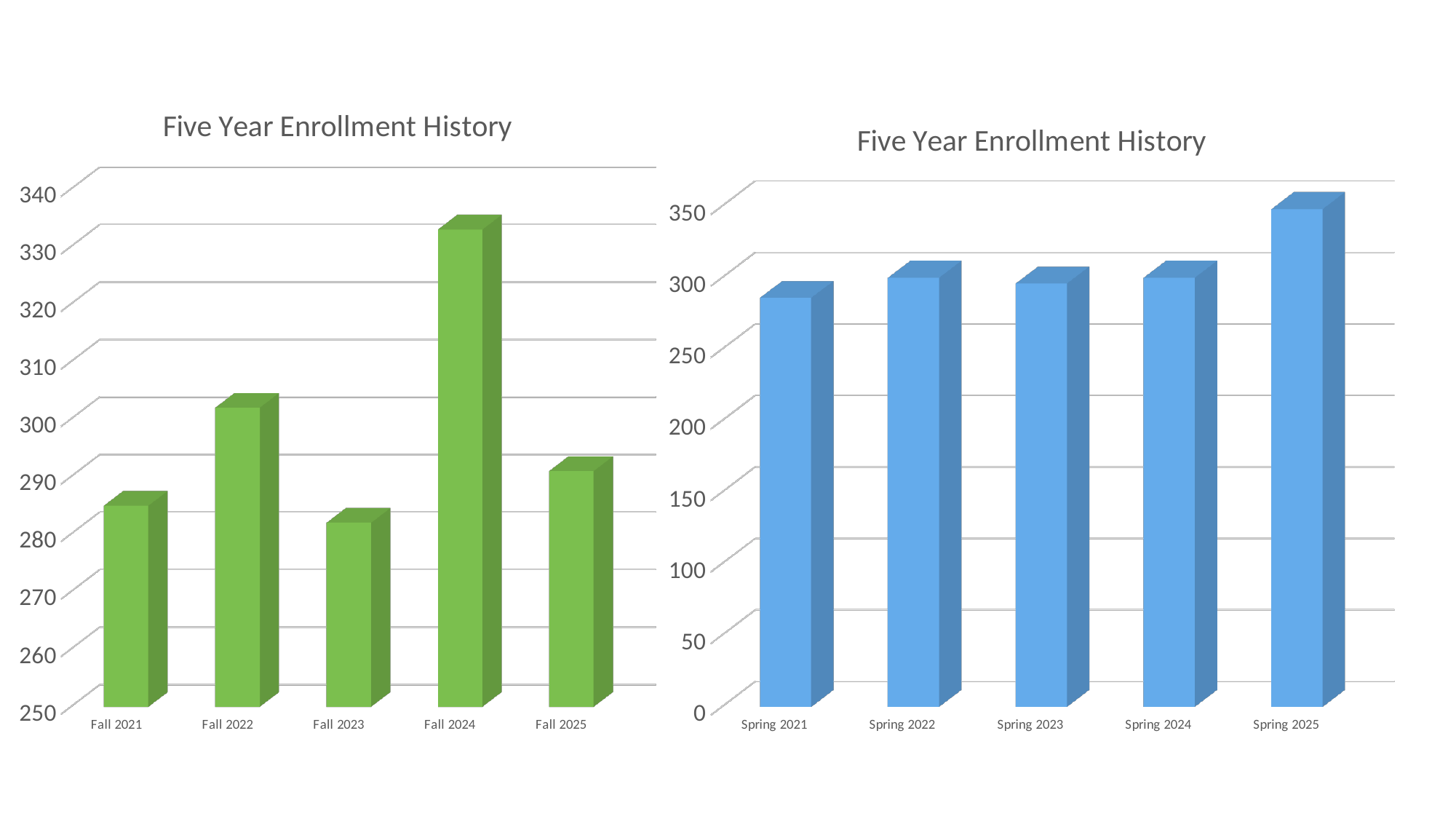
On the left chart, is the value for Fall 2024 greater or less than 320? greater What kind of chart is the left chart? bar chart On the right chart, is the value for Spring 2025 greater or less than 300? greater On the left chart (green bars), which term has the lowest enrollment? Fall 2023 What is the title of the right chart? Five Year Enrollment History On the left chart, is the value for Fall 2025 greater or less than 300? less On the right chart (blue bars), which term has the highest enrollment? Spring 2025 On the left chart (green bars), which term has the highest enrollment? Fall 2024 How many terms are shown on the right chart? 5 On the left chart, which is larger, the value for Fall 2022 or the value for Fall 2025? Fall 2022 On the right chart (blue bars), which term has the lowest enrollment? Spring 2021